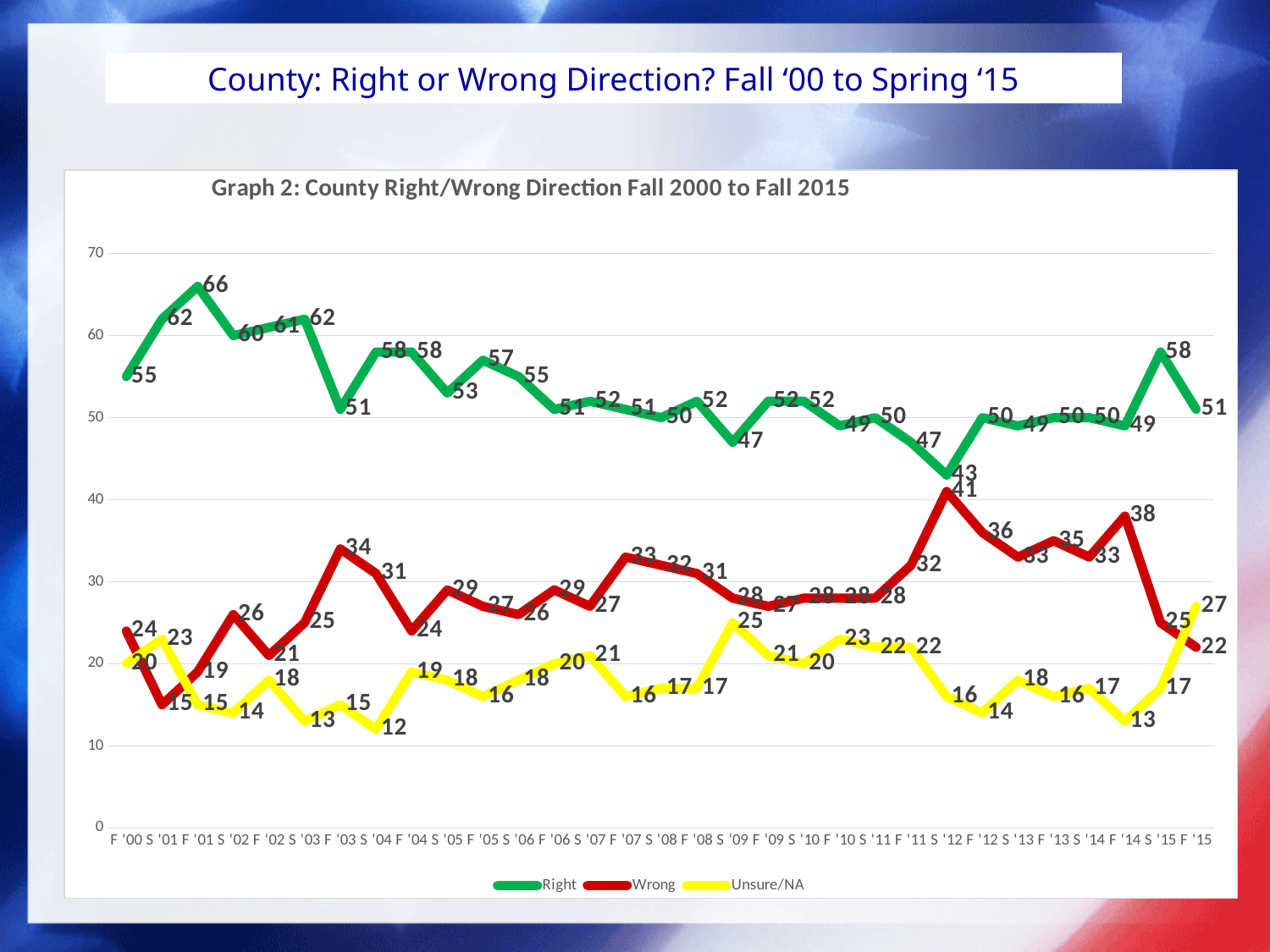
What is the value of the Wrong series at F '15? 22 At which point does the Unsure/NA series reach its lowest value? S '04 What is the difference between the Right and Wrong values at F '15? 29 At which point does the Wrong series reach its highest value? S '12 What is the value of the Right series at F '00? 55 At which point does the Right series reach its lowest value? S '12 How many series does the legend list? 3 What is the value of the Unsure/NA series at F '15? 27 What colour is the Wrong series line? red Which is larger for the Right series: the value at F '01 or the value at S '15? F '01 What kind of chart is shown on the slide? line chart At which point does the Right series reach its highest value? F '01